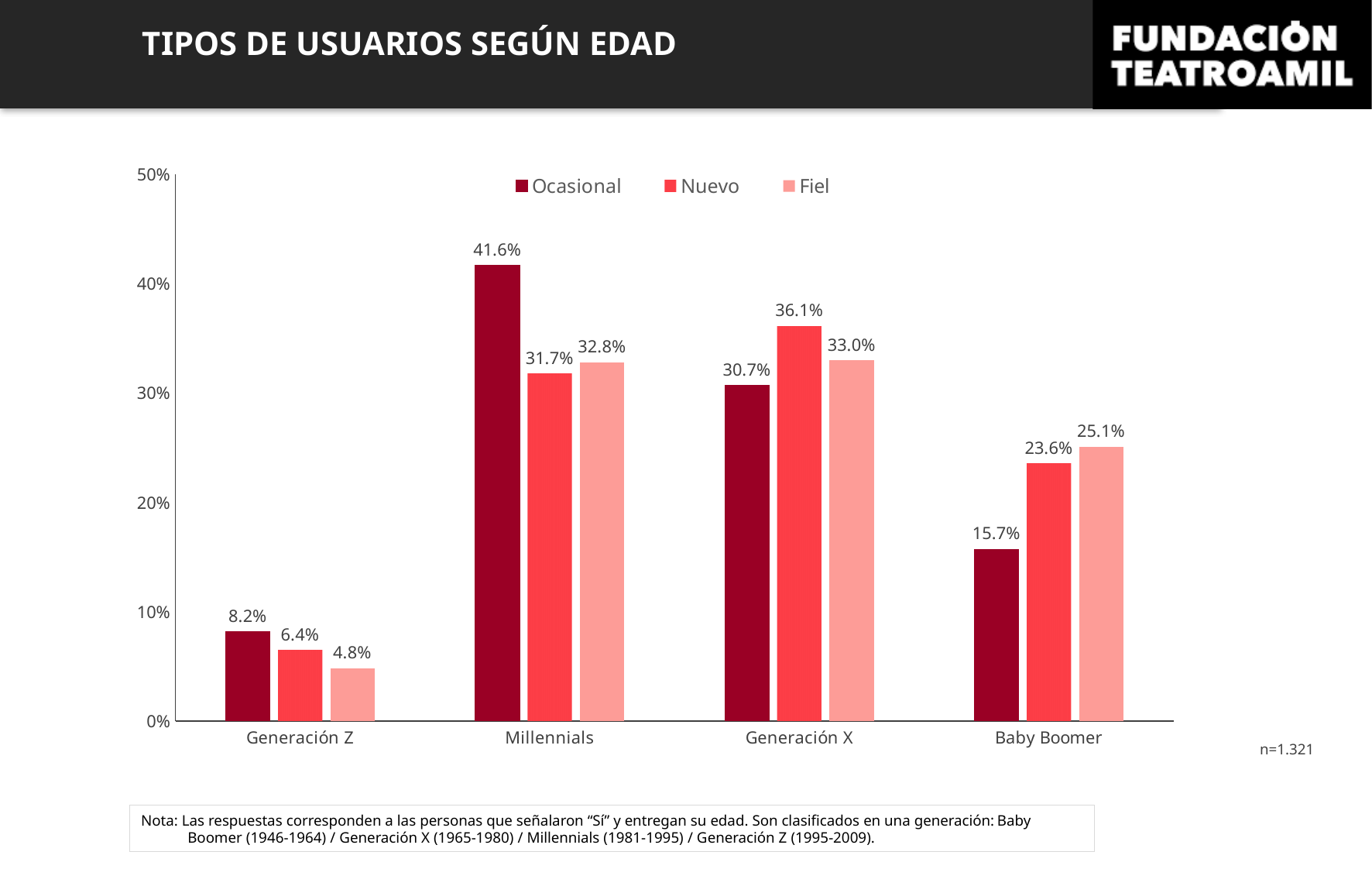
What kind of chart is shown on the slide? Bar chart What is the title of the chart? TIPOS DE USUARIOS SEGÚN EDAD What sample size (n) is shown on the slide? n=1.321 Which is larger for Baby Boomer: the Nuevo value or the Ocasional value? Nuevo How many generation categories are shown on the x axis? 4 Which generation has the highest Ocasional value? Millennials Which generation has the lowest Fiel value? Generación Z What is the Ocasional value for Millennials? 41.6% How many series does the legend list? 3 What is the Fiel value for Baby Boomer? 25.1% What is the Nuevo value for Generación X? 36.1% What is the difference between the Ocasional and Nuevo values for Millennials? 9.9%